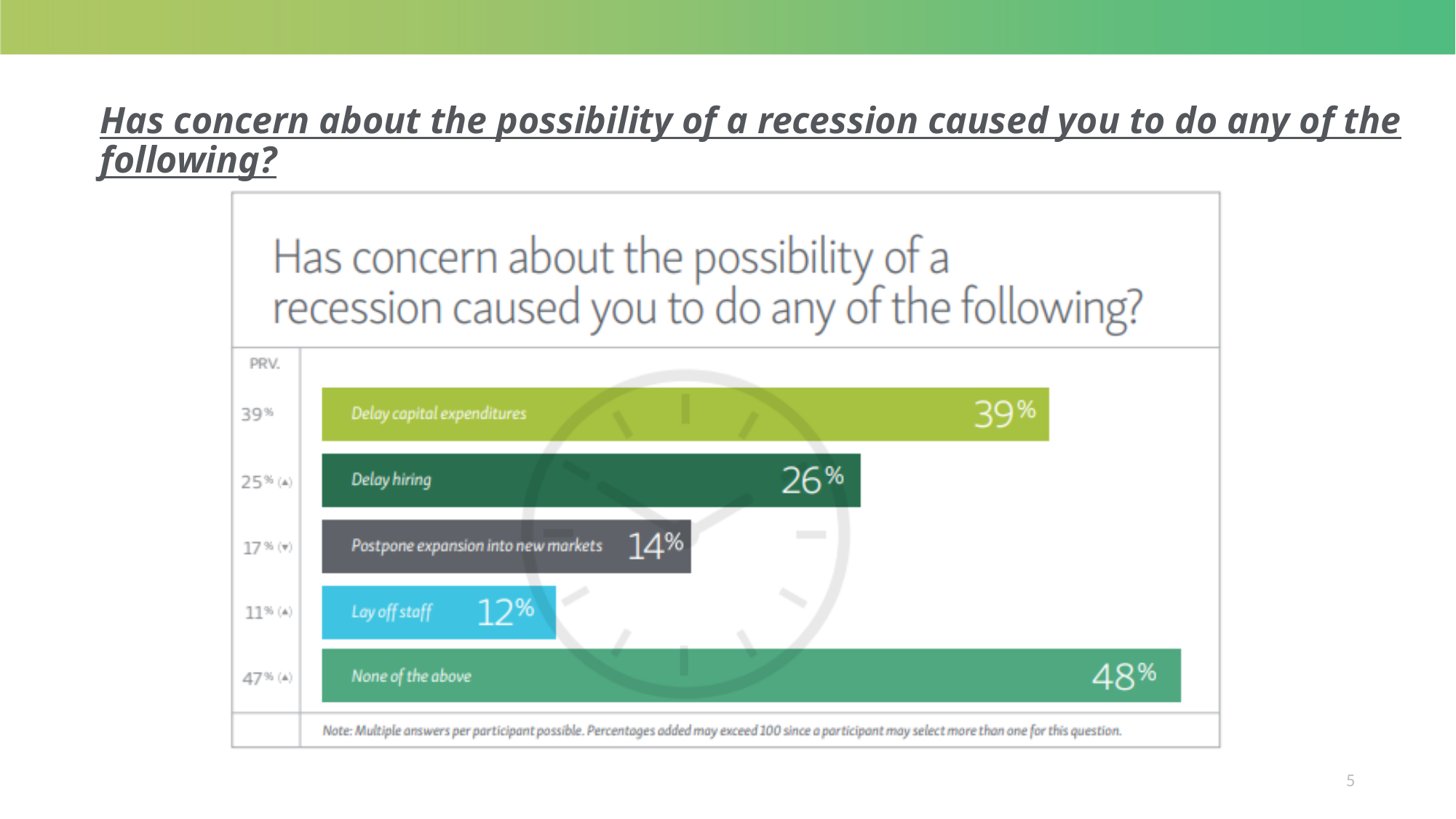
What is the value shown for "Delay hiring"? 26% Which category has the lowest percentage? Lay off staff What percentage is shown for "Postpone expansion into new markets"? 14% What kind of chart is shown on the slide? Bar chart What is the difference between the percentages for "Delay capital expenditures" and "Delay hiring"? 13% What is the value for "Lay off staff"? 12% What was the previous (PRV.) value listed for "Delay hiring"? 25% What percentage of respondents selected "None of the above"? 48% Which is larger, the value for "Postpone expansion into new markets" or the value for "Lay off staff"? Postpone expansion into new markets Which category has the highest percentage? None of the above What percentage of respondents said concern about a recession caused them to delay capital expenditures? 39% How many categories (bars) are shown in the chart? 5